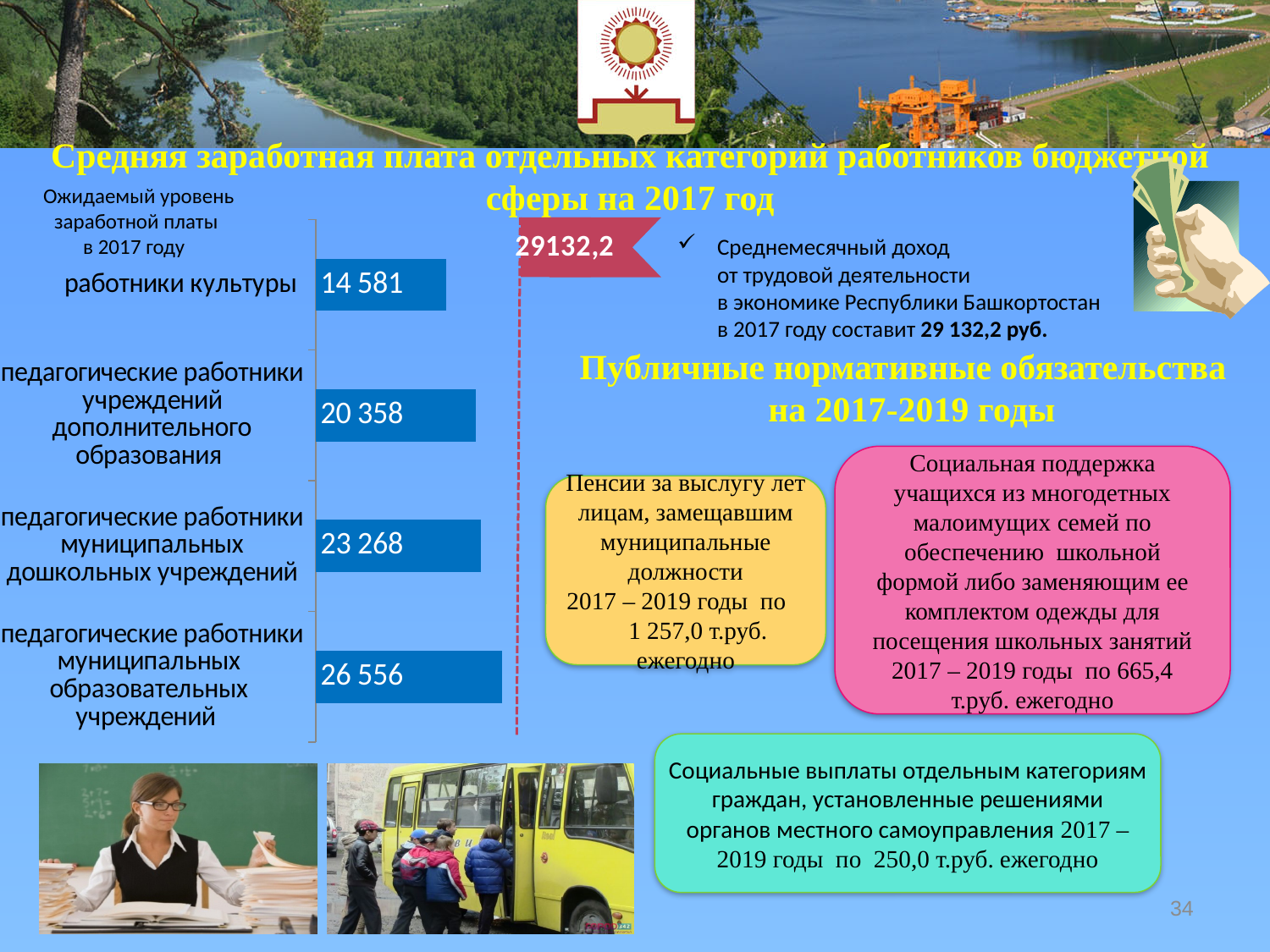
What value is shown for педагогические работники учреждений дополнительного образования? 20 358 What is the title text above the bar chart on the left? Ожидаемый уровень заработной платы в 2017 году What is the difference between the values for педагогические работники муниципальных образовательных учреждений and работники культуры? 11 975 How many categories are shown in the bar chart? 4 What is the expected 2017 salary value shown for работники культуры? 14 581 What value is shown for педагогические работники муниципальных дошкольных учреждений? 23 268 What value is shown for педагогические работники муниципальных образовательных учреждений? 26 556 Which category has the highest value in the bar chart? педагогические работники муниципальных образовательных учреждений What is the difference between the values for педагогические работники муниципальных дошкольных учреждений and педагогические работники учреждений дополнительного образования? 2 910 Which is larger: the value for педагогические работники муниципальных дошкольных учреждений or for педагогические работники учреждений дополнительного образования? педагогические работники муниципальных дошкольных учреждений Which category has the lowest value in the bar chart? работники культуры What type of chart is used to show the expected salary levels? bar chart